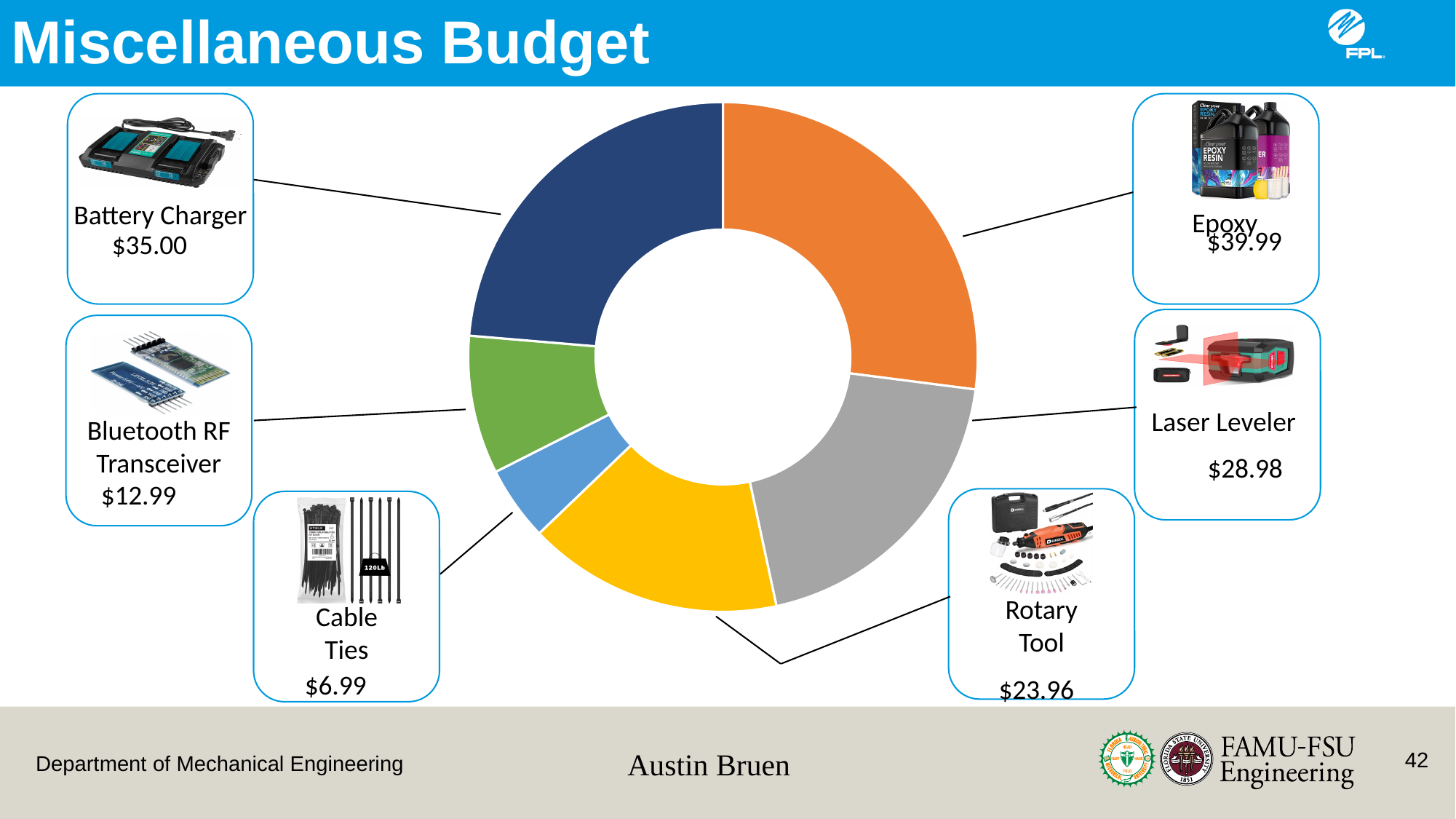
What is the cost of the Laser Leveler? $28.98 How much more does the Epoxy cost than the Battery Charger? $4.99 Which item has the lowest cost in the Miscellaneous Budget chart? Cable Ties What is the difference in cost between the Bluetooth RF Transceiver and the Cable Ties? $6.00 How many items are shown in the Miscellaneous Budget chart? 6 What is the cost of the Epoxy in the Miscellaneous Budget chart? $39.99 Which item has the highest cost in the Miscellaneous Budget chart? Epoxy What kind of chart is used on the slide? doughnut chart What colour is the slice for the Cable Ties? light blue Which costs more, the Laser Leveler or the Rotary Tool? Laser Leveler What is the cost of the Bluetooth RF Transceiver? $12.99 What is the cost of the Rotary Tool? $23.96